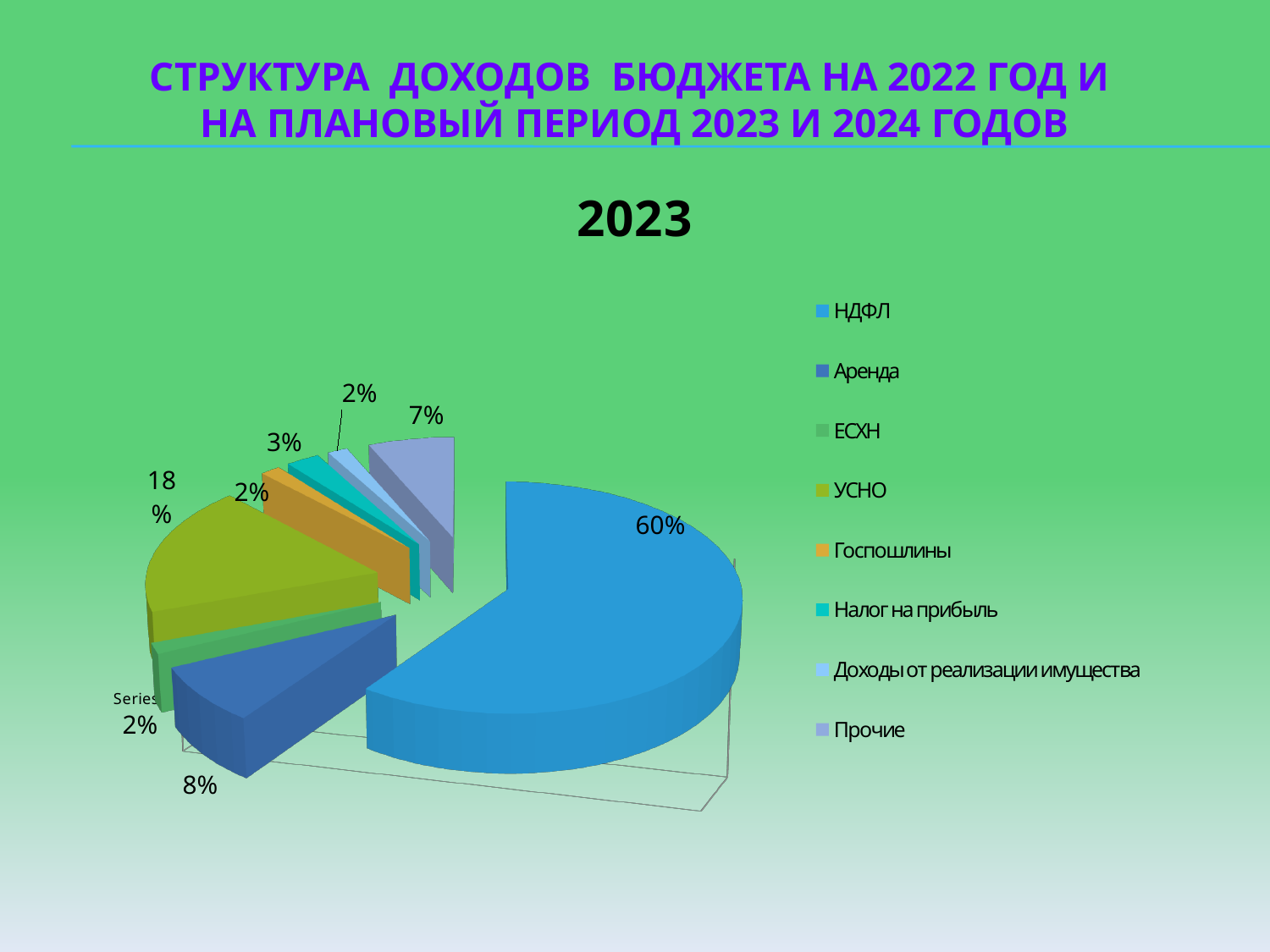
What is the difference between the shares of НДФЛ and УСНО in the 2023 pie chart? 42% What is the share of Аренда in the 2023 pie chart? 8% Which category has the largest share in the 2023 pie chart? НДФЛ What is the share of НДФЛ in the 2023 pie chart? 60% What year is shown as the title of the pie chart? 2023 What is the share of УСНО in the 2023 pie chart? 18% Which legend entry is shown in orange in the 2023 pie chart? Госпошлины What is the share of Прочие in the 2023 pie chart? 7% What is the share of Налог на прибыль in the 2023 pie chart? 3% How many categories does the legend of the 2023 pie chart list? 8 What type of chart is shown on the slide? pie chart Which is larger in the 2023 pie chart, УСНО or Аренда? УСНО